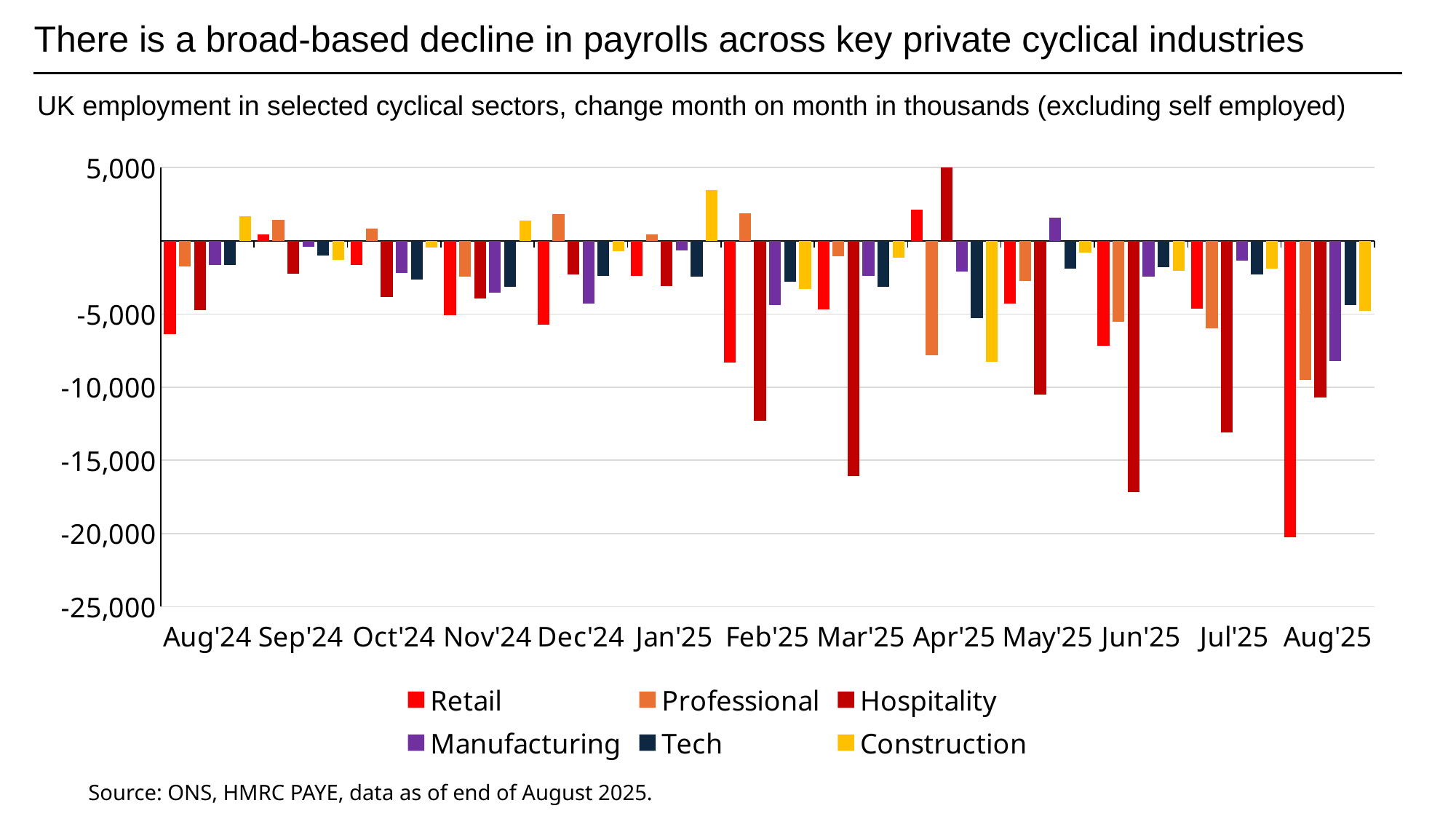
Is the value for Hospitality in Mar'25 greater or less than -15,000? less Is the value for Manufacturing in Aug'25 greater or less than -10,000? greater How many months are shown along the x axis? 13 Which is more negative: Retail in Aug'25 or Hospitality in Jun'25? Retail in Aug'25 What is the title of the slide? There is a broad-based decline in payrolls across key private cyclical industries What kind of chart is shown on the slide? bar chart Is the value for Construction in Apr'25 greater or less than -5,000? less How many series does the legend list? 6 Which series has the lowest (most negative) bar on the chart, and in which month? Retail, Aug'25 Which series has the highest bar on the chart, and in which month? Hospitality, Apr'25